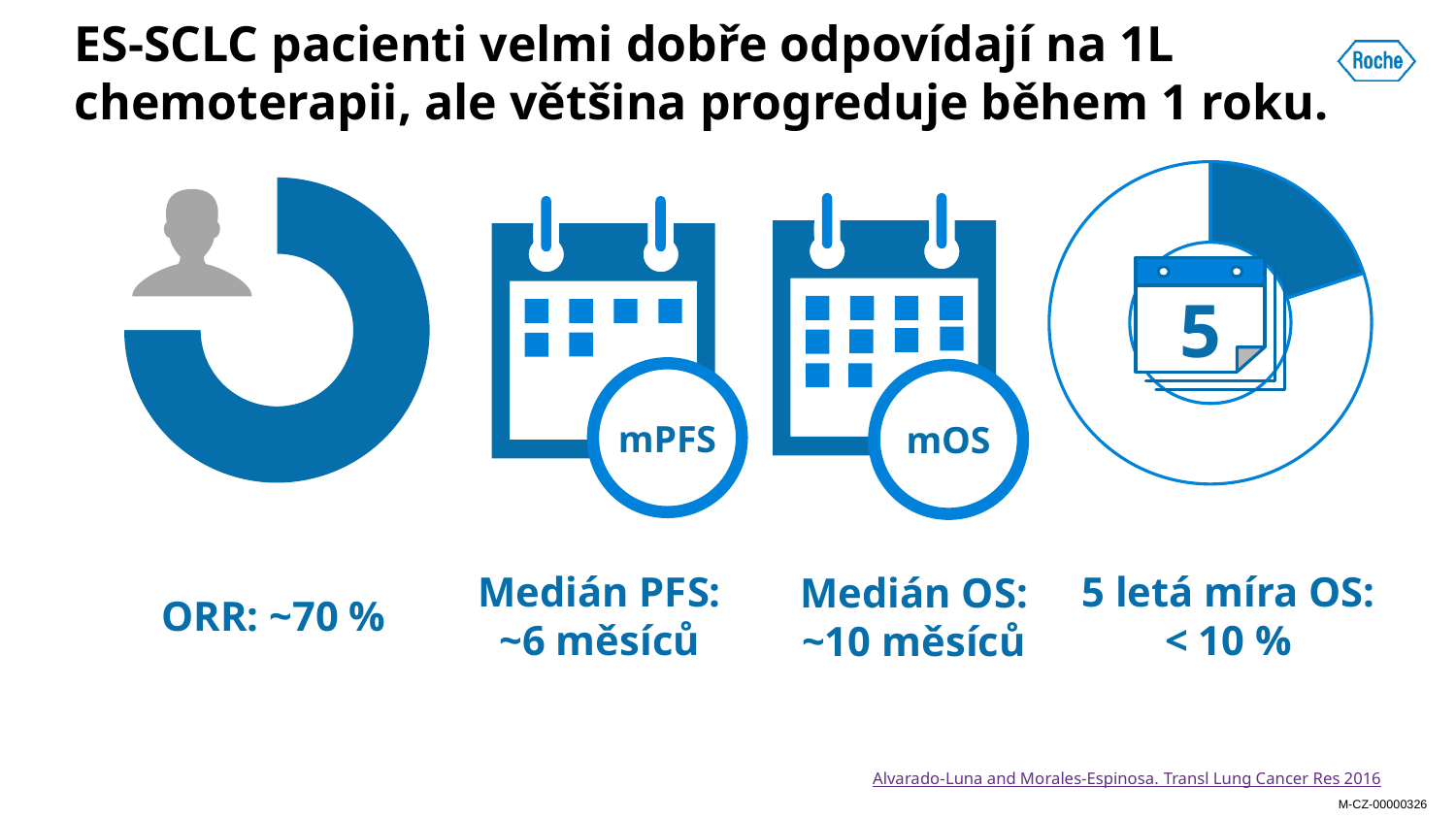
What kind of chart-like graphic is used for the 5-year OS rate on the right of the slide? Donut chart Which is larger on the slide: the ORR or the 5-year OS rate? ORR What 5-year OS rate is printed beneath the pie-shaped icon on the right of the slide? < 10 % What label is printed in the circle on the second calendar icon? mOS What kind of chart-like graphic is used for the ORR figure on the left of the slide? Donut chart What median OS value is printed on the slide? ~10 měsíců What label is printed in the circle on the first calendar icon? mPFS How many outcome measures (ORR, median PFS, median OS, 5-year OS rate) are shown across the slide? 4 What median PFS value is printed on the slide? ~6 měsíců What ORR value is printed beneath the donut-shaped icon on the left of the slide? ~70 % Which is larger on the slide: the median OS or the median PFS? Median OS